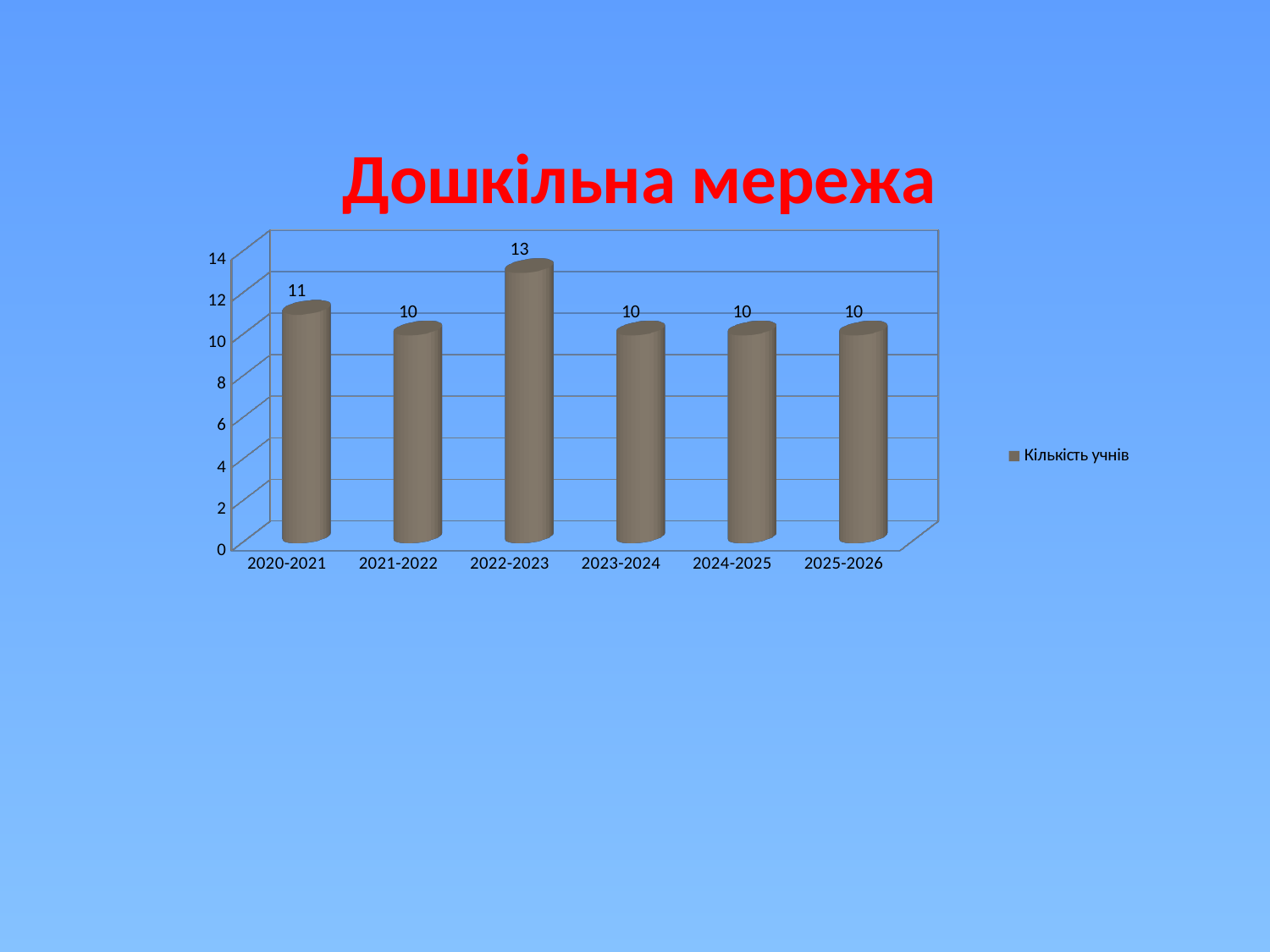
What kind of chart is shown on the slide? bar chart What is the difference between the values for 2022-2023 and 2021-2022? 3 Which category has the highest value? 2022-2023 How many series does the legend list? 1 What is the difference between the values for 2020-2021 and 2023-2024? 1 How many categories are shown on the x axis? 6 What is the title of the chart? Дошкільна мережа What is the value for 2020-2021? 11 What is the value for 2022-2023? 13 What is the value for 2025-2026? 10 Is the value for 2022-2023 greater or less than 12? greater Which is larger, the value for 2020-2021 or the value for 2024-2025? 2020-2021